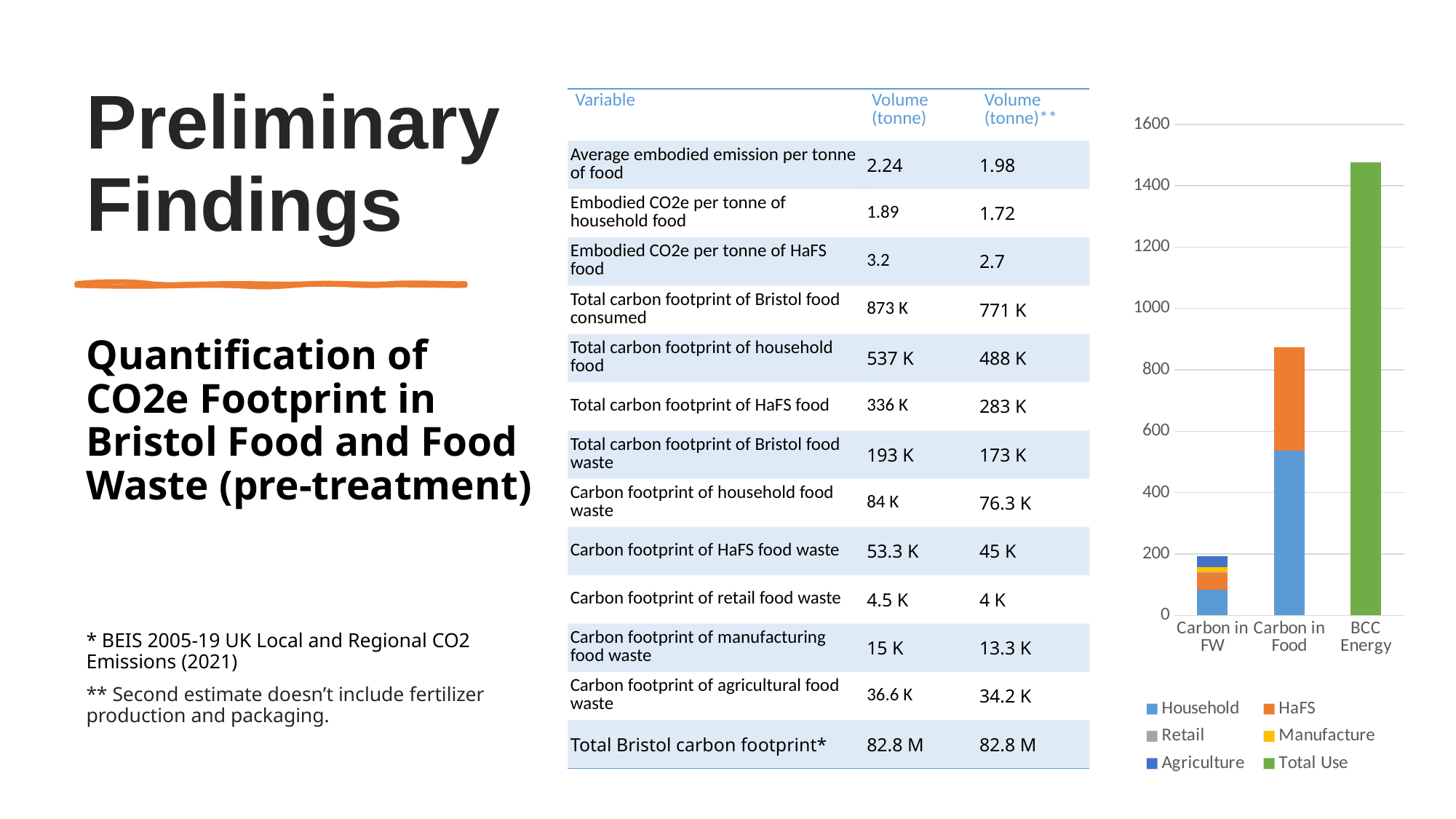
How many series does the chart's legend list? 6 Which category has the shortest bar in the chart? Carbon in FW Which bar is taller, Carbon in Food or Carbon in FW? Carbon in Food Is the total value for Carbon in Food greater or less than 800? greater What kind of chart is shown on the right of the slide? Stacked bar chart Is the Household segment of the Carbon in Food bar greater or less than 400? greater Is the total value for BCC Energy greater or less than 1400? greater Which series is shown in green in the chart's legend? Total Use How many categories are shown on the x axis of the chart? 3 Which category's bar consists only of the Total Use series? BCC Energy Which category has the tallest bar in the chart? BCC Energy